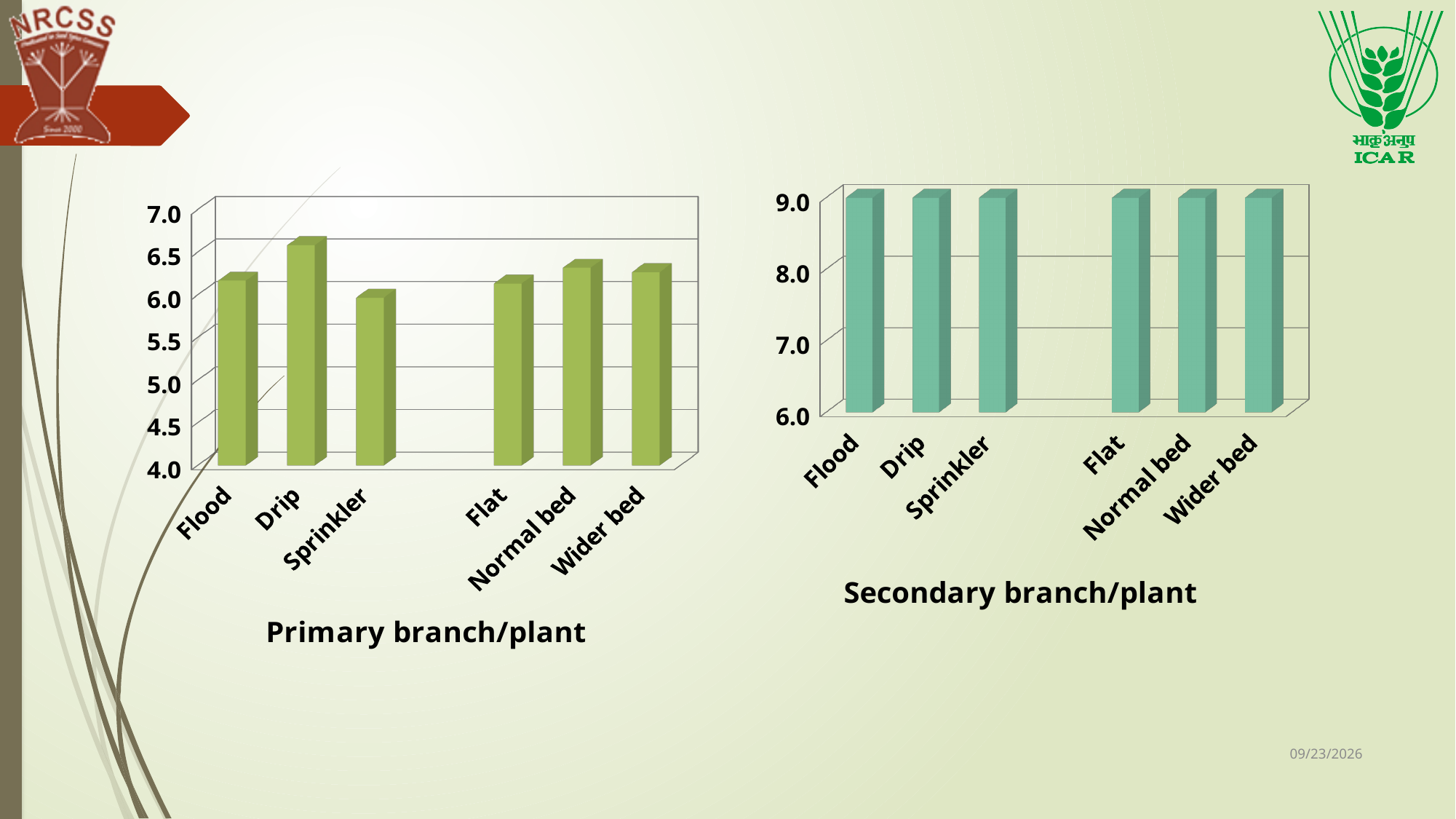
How many categories are shown in the Primary branch/plant chart? 6 In the Primary branch/plant chart, which is larger, Normal bed or Flat? Normal bed In the Primary branch/plant chart, is the value for Drip greater or less than 6.0? greater How many categories are shown in the Secondary branch/plant chart? 6 In the Primary branch/plant chart, is the value for Normal bed greater or less than 6.0? greater In the Primary branch/plant chart, which is larger, Drip or Sprinkler? Drip In the Primary branch/plant chart, which category has the lowest value? Sprinkler What kind of chart is the Primary branch/plant chart? bar chart In the Secondary branch/plant chart, is the value for Flood greater or less than 8.0? greater What is the title of the chart on the right side of the slide? Secondary branch/plant In the Primary branch/plant chart, which category has the highest value? Drip